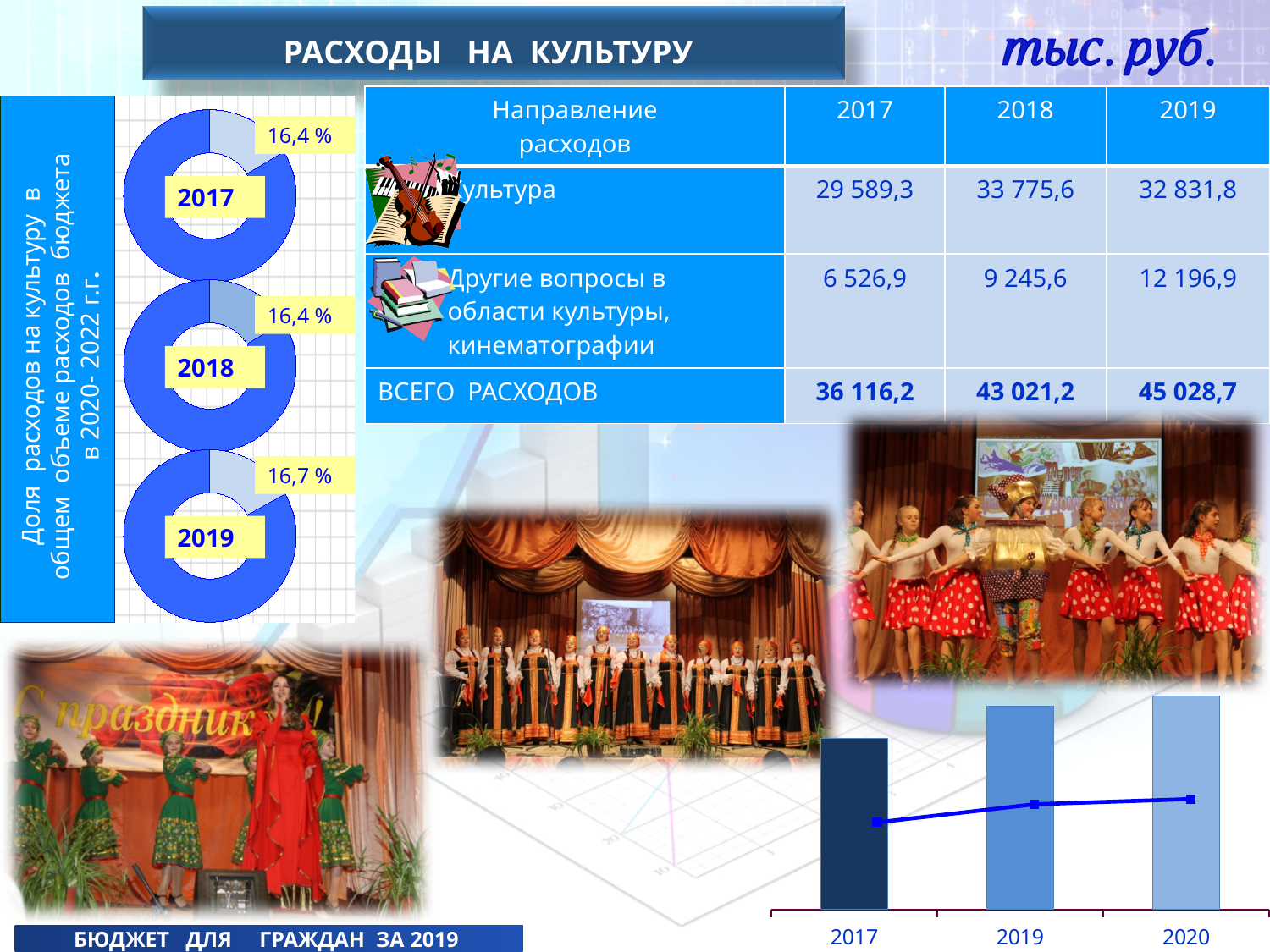
In the bar chart in the bottom right corner, do the bars rise or fall from 2017 to 2020? Rise In the bar chart in the bottom right corner, which bar is taller: 2017 or 2020? 2020 In the donut chart for 2019 on the left, what share is shown for culture expenditure? 16,7 % What kind of chart is shown in the bottom right corner of the slide? Bar chart with a line How many donut charts are shown on the left side of the slide? 3 In the donut chart for 2018 on the left, what share is shown for culture expenditure? 16,4 % Among the three donut charts on the left, which year shows the highest share of culture expenditure? 2019 What years are labelled on the x axis of the bar chart in the bottom right corner? 2017, 2019, 2020 What is the difference between the culture share shown for 2019 and for 2018 in the donut charts? 0,3 % In the donut chart for 2017 on the left, what share of total budget expenditure goes to culture? 16,4 % How many categories are shown on the x axis of the bar chart in the bottom right corner? 3 What kind of chart is used on the left side of the slide to show the share of culture expenditure by year? Donut (pie) chart